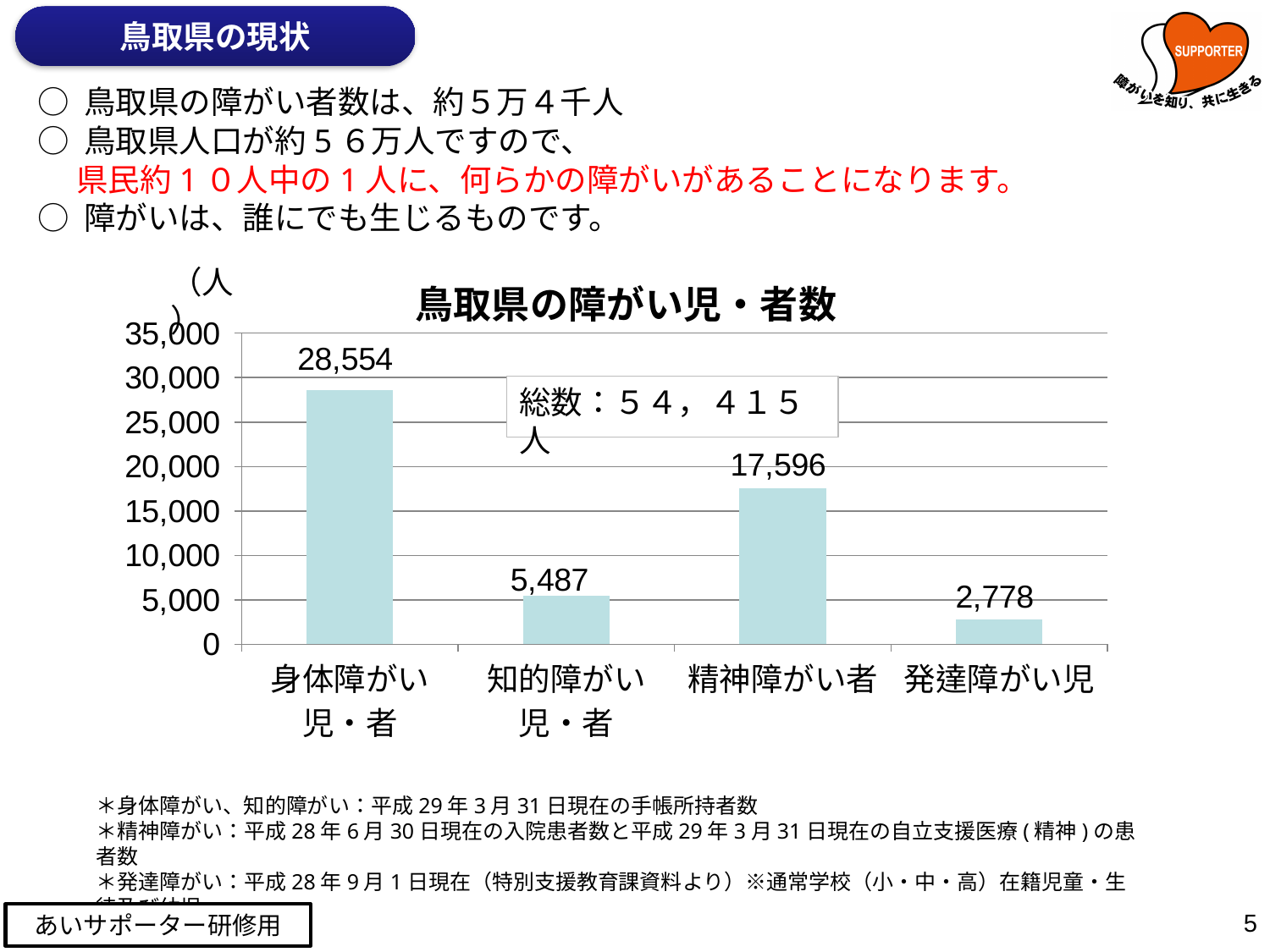
How many categories are shown in the chart? 4 What is the value for 精神障がい者 in the chart? 17,596 What is the value for 発達障がい児 in the chart? 2,778 Which category has the highest value in the chart? 身体障がい児・者 What kind of chart is shown on the slide? Bar chart Which category has the lowest value in the chart? 発達障がい児 What is the value for 身体障がい児・者 in the chart? 28,554 What is the difference between the values for 身体障がい児・者 and 精神障がい者? 10,958 What is the title of the chart? 鳥取県の障がい児・者数 Which is larger, the value for 知的障がい児・者 or the value for 発達障がい児? 知的障がい児・者 What total (総数) is shown in the box on the chart? ５４，４１５人 What is the value for 知的障がい児・者 in the chart? 5,487